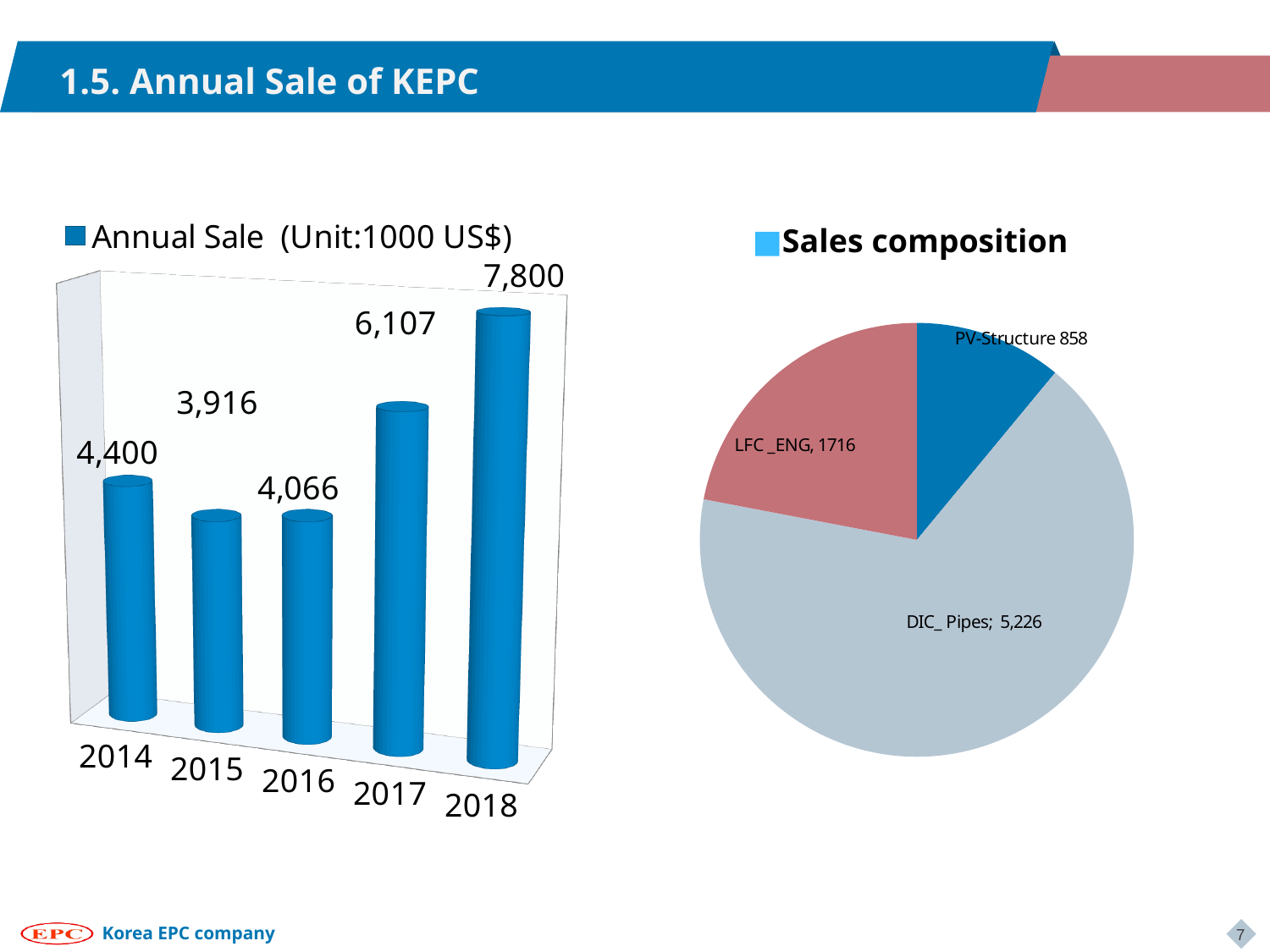
In the Annual Sale chart, which year has the highest annual sale? 2018 In the Annual Sale chart, do the values rise or fall from 2016 to 2018? rise In the Sales composition pie chart, how many slices are there? 3 In the Annual Sale chart, which year has the lowest annual sale? 2015 In the Sales composition pie chart, what is the value for DIC_ Pipes? 5,226 In the Annual Sale chart, what was the annual sale in 2015? 3,916 In the Sales composition pie chart, which slice is the smallest? PV-Structure In the Annual Sale chart, what is the difference between the 2018 and 2017 annual sales? 1,693 What kind of chart is the Annual Sale chart? bar chart In the Annual Sale chart, what was the annual sale in 2018? 7,800 In the Annual Sale chart, how many years are shown on the x axis? 5 In the Annual Sale chart, which year had the larger annual sale, 2014 or 2016? 2014